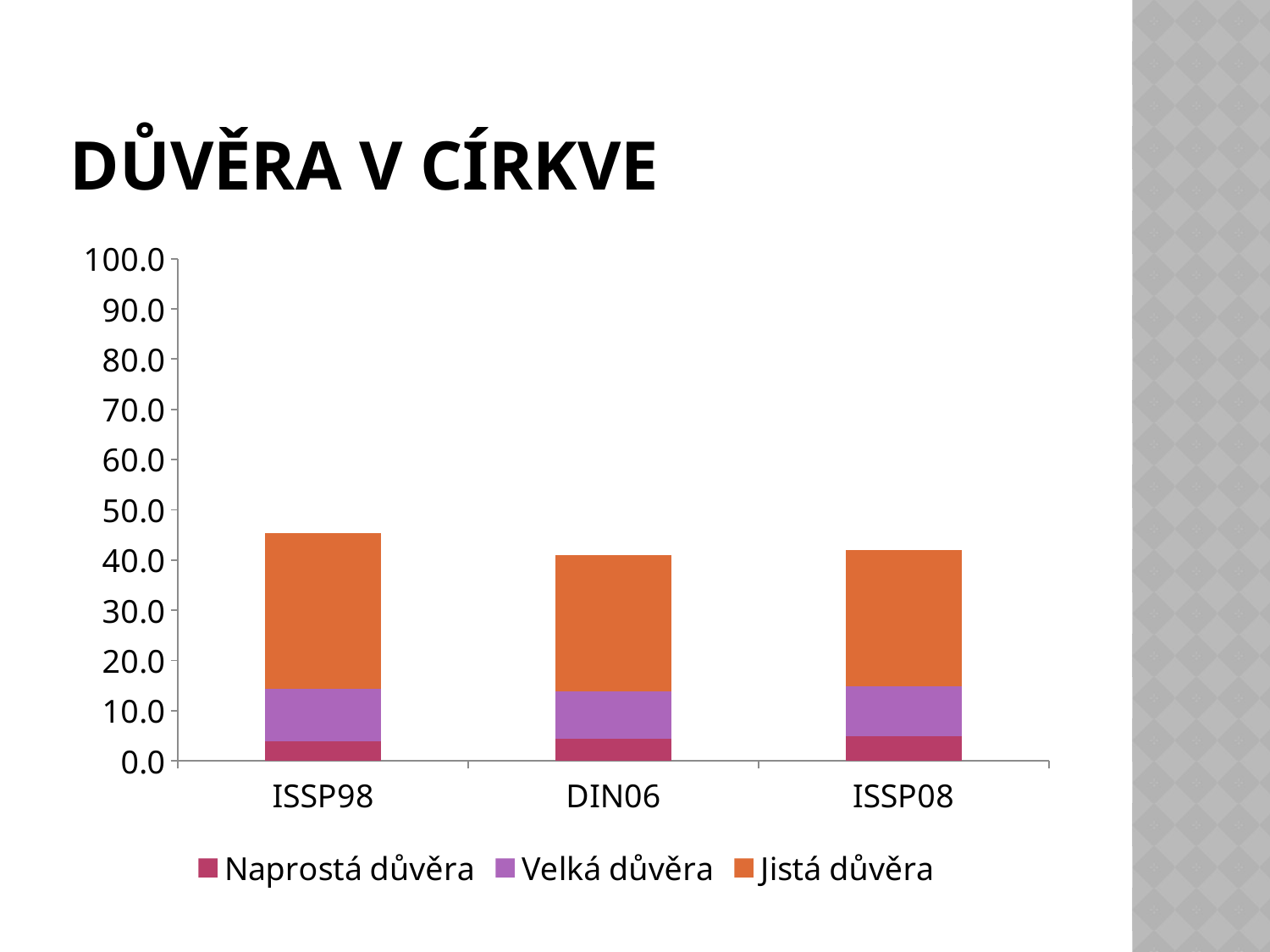
Which category has the tallest stacked bar? ISSP98 How many series does the legend list? 3 Is the total stacked bar for DIN06 greater or less than 50? less What is the title of the chart? DŮVĚRA V CÍRKVE Is the total stacked bar for ISSP08 greater or less than 50? less Is the total stacked bar for ISSP98 greater or less than 50? less What kind of chart is shown on the slide? stacked bar chart How many categories are shown on the x axis? 3 Which series is shown in orange in the legend? Jistá důvěra Which series forms the largest segment of each stacked bar? Jistá důvěra Which is larger, the total stacked bar for ISSP98 or for DIN06? ISSP98